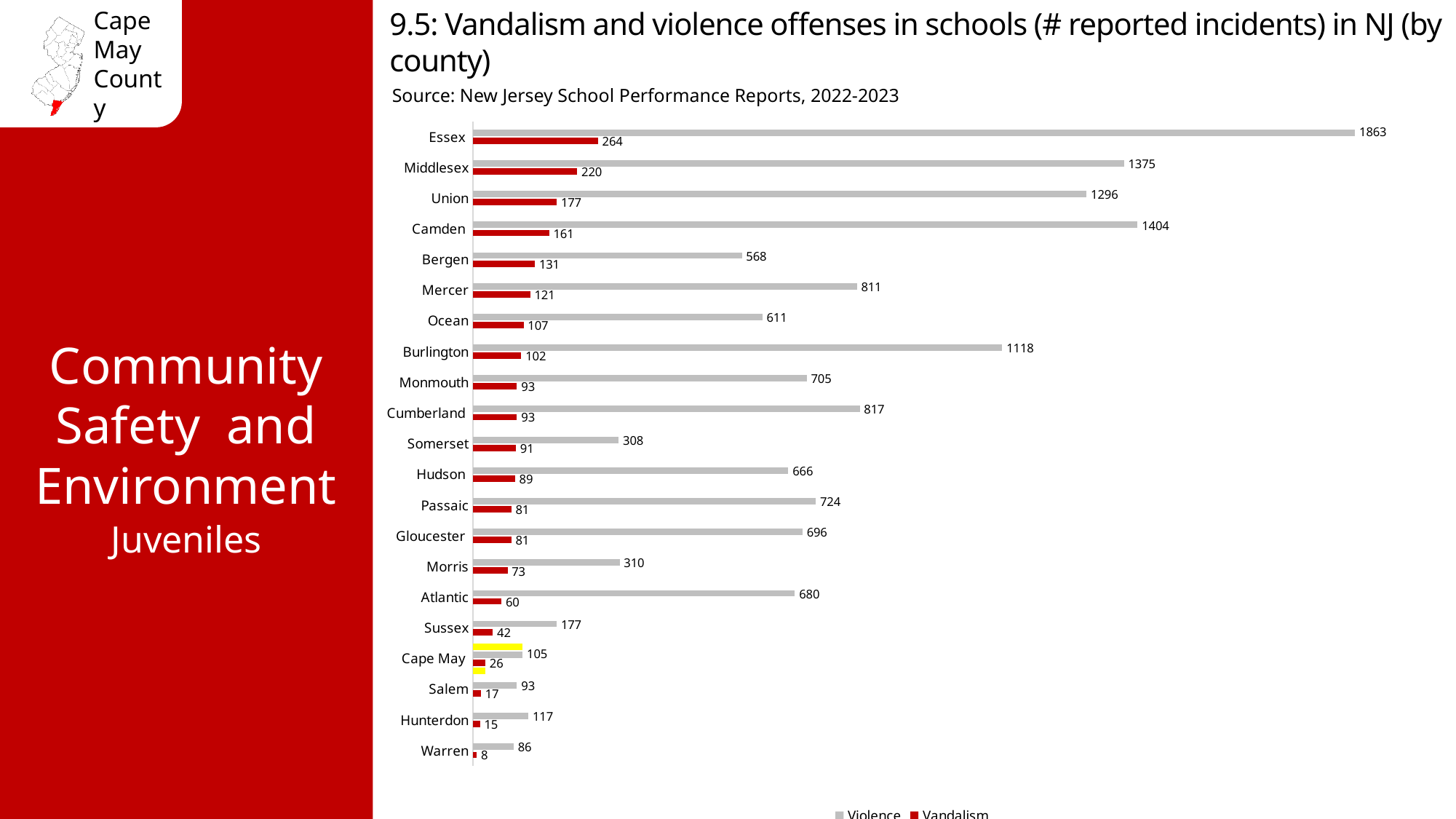
How many counties are shown in the chart? 21 What is the difference between the violence incidents in Essex and Camden? 459 Which series is shown in red in the chart? Vandalism What is the difference between the vandalism incidents in Essex and Cape May? 238 Which county has more reported violence incidents, Middlesex or Camden? Camden What is the number of reported vandalism incidents in Middlesex County? 220 Which county has the highest number of reported violence incidents? Essex What type of chart is shown on the slide? Bar chart Which county has the lowest number of reported vandalism incidents? Warren What is the number of reported vandalism incidents in Cape May County? 26 How many series does the legend list? 2 What is the number of reported violence incidents in Cape May County? 105